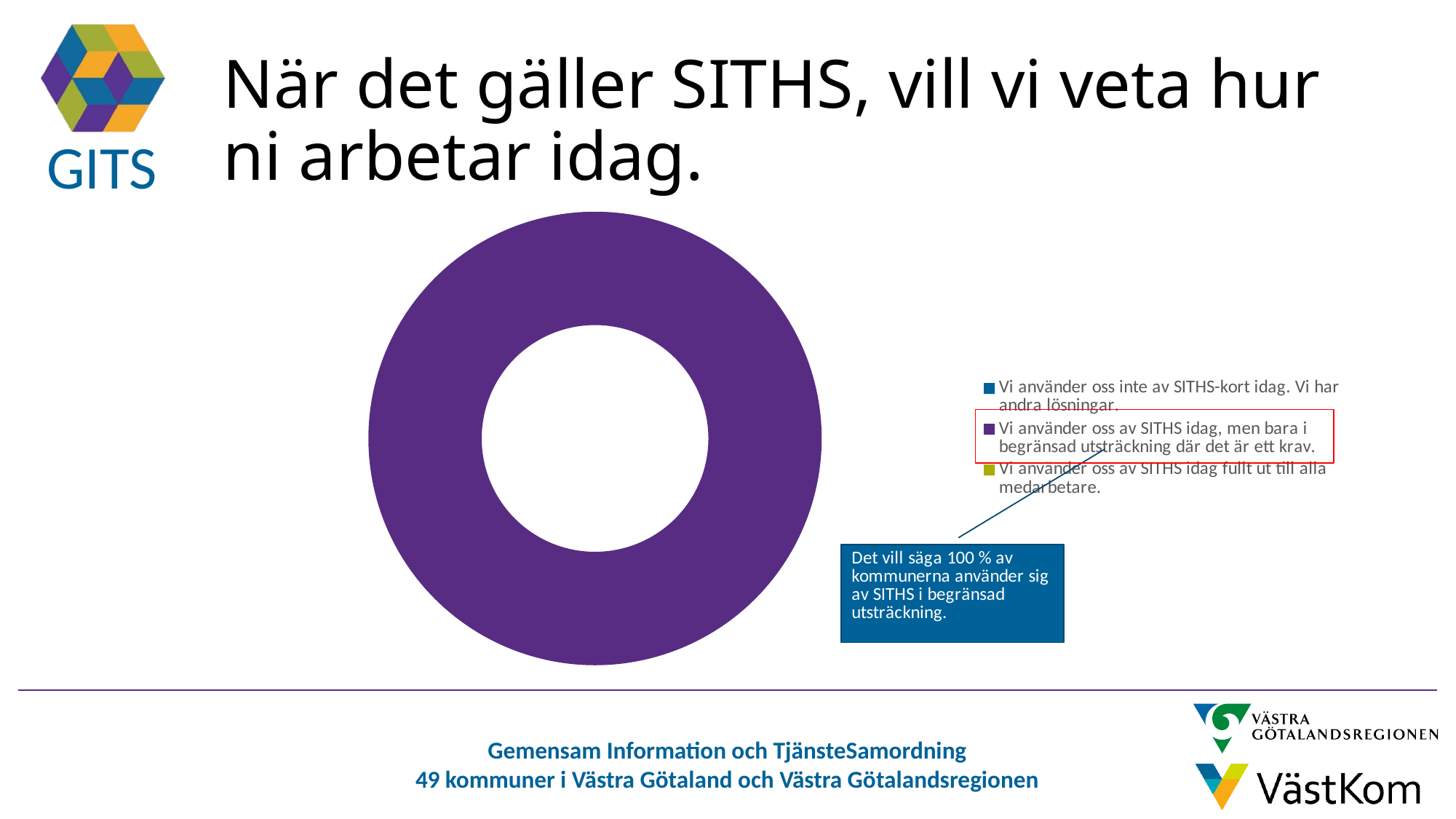
Which legend category has the smallest share in the chart: 'Vi använder oss av SITHS idag fullt ut till alla medarbetare.' or 'Vi använder oss av SITHS idag, men bara i begränsad utsträckning där det är ett krav.'? Vi använder oss av SITHS idag fullt ut till alla medarbetare. According to the callout, what share of the municipalities use SITHS to a limited extent? 100 % What colour is the legend marker for 'Vi använder oss av SITHS idag, men bara i begränsad utsträckning där det är ett krav.'? purple What colour is the legend marker for 'Vi använder oss inte av SITHS-kort idag. Vi har andra lösningar.'? blue What kind of chart is shown on the slide? doughnut chart How many visible slices does the doughnut chart have? 1 How many entries does the chart's legend list? 3 Which legend category does the entire doughnut represent? Vi använder oss av SITHS idag, men bara i begränsad utsträckning där det är ett krav.